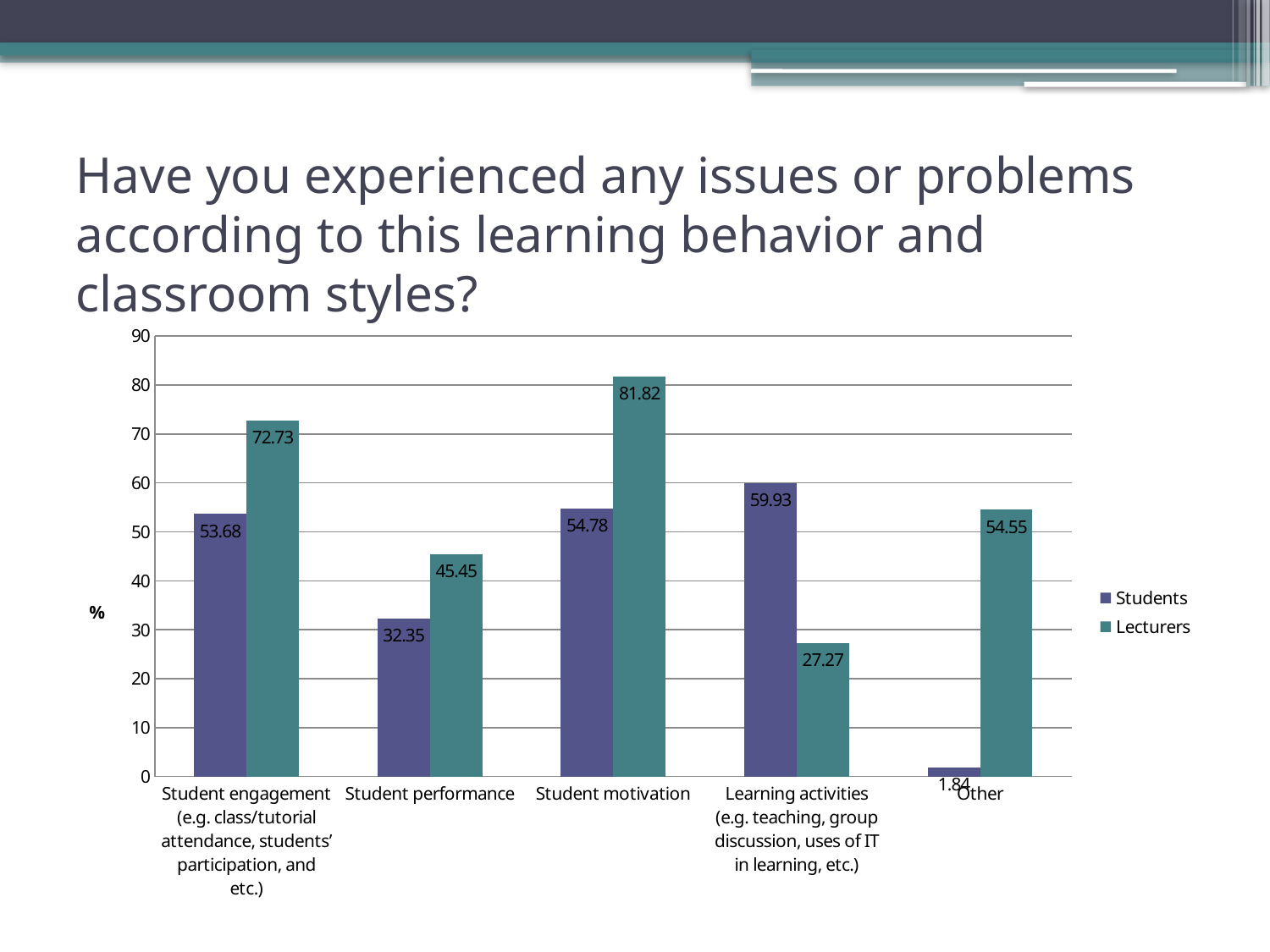
What label is shown on the vertical axis? % For Learning activities, which series has the larger value, Students or Lecturers? Students Which category has the highest Lecturers value? Student motivation What is the difference between the Lecturers and Students values for Student motivation? 27.04 How many series does the legend list? 2 What is the Lecturers value for Student engagement? 72.73 What is the Lecturers value for Learning activities? 27.27 What is the Students value for Student motivation? 54.78 What is the Students value for Other? 1.84 What kind of chart is shown on the slide? Bar chart Which category has the lowest Students value? Other How many categories are shown on the x axis? 5